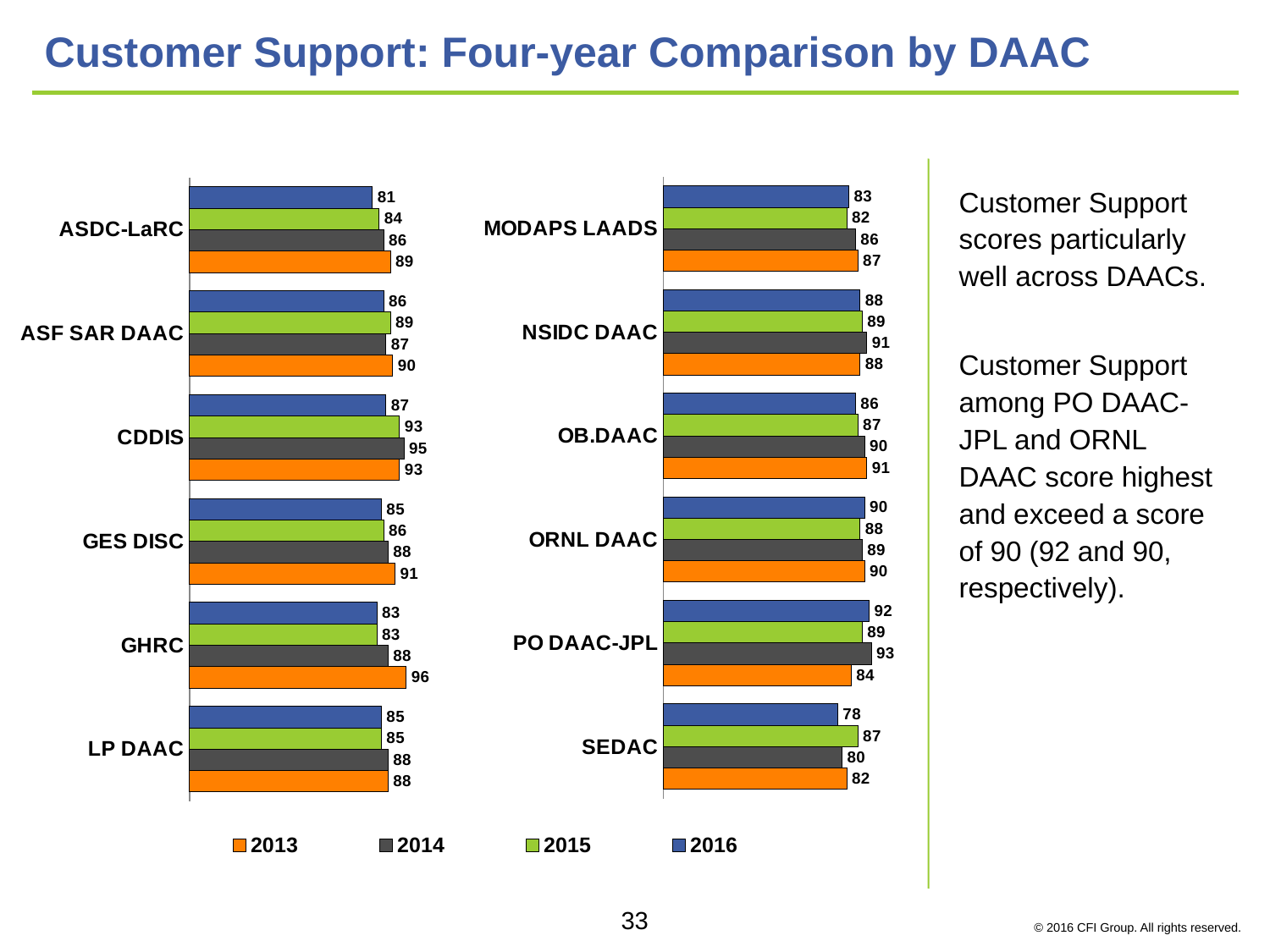
How many series does the legend list? 4 In the right chart, what is the 2014 score for PO DAAC-JPL? 93 In the left chart, what is the difference between the 2013 and 2016 scores for GHRC? 13 In the left chart, what is the 2016 Customer Support score for ASDC-LaRC? 81 How many DAACs are shown in the left chart? 6 In the right chart, what is the difference between the 2016 scores of PO DAAC-JPL and ORNL DAAC? 2 In the right chart, which is larger for SEDAC: the 2015 score or the 2014 score? 2015 In the left chart, which DAAC has the highest 2013 score? GHRC What type of chart is used on this slide? Bar chart Which colour represents 2013 in the legend? Orange In the right chart, which DAAC has the lowest 2016 score? SEDAC In the left chart, what is the 2014 score for CDDIS? 95